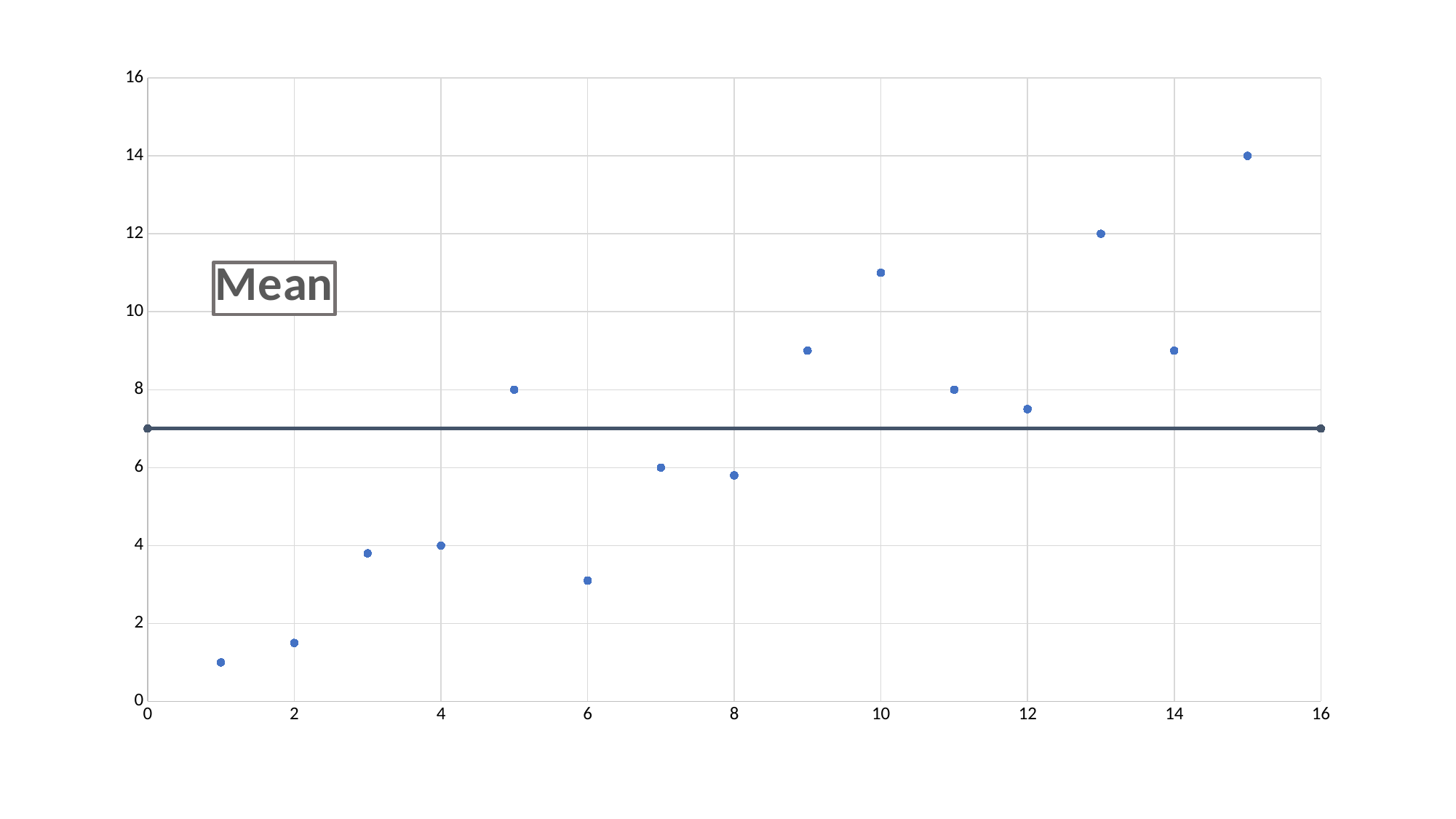
What kind of chart is shown on the slide? scatter chart At which x value is the lowest point plotted? 1 What is the y value of the point at x = 15? 14 What is the y value of the point at x = 5? 8 How many data points are plotted on the chart (excluding the horizontal line)? 15 What label is shown for the horizontal line across the chart? Mean Is the y value of the point at x = 10 greater or less than 10? greater What is the y value of the point at x = 13? 12 Is the y value of the point at x = 6 greater or less than 4? less At which x value is the highest point plotted? 15 What is the y value of the point at x = 4? 4 Which point has the larger y value, the one at x = 9 or the one at x = 8? x = 9